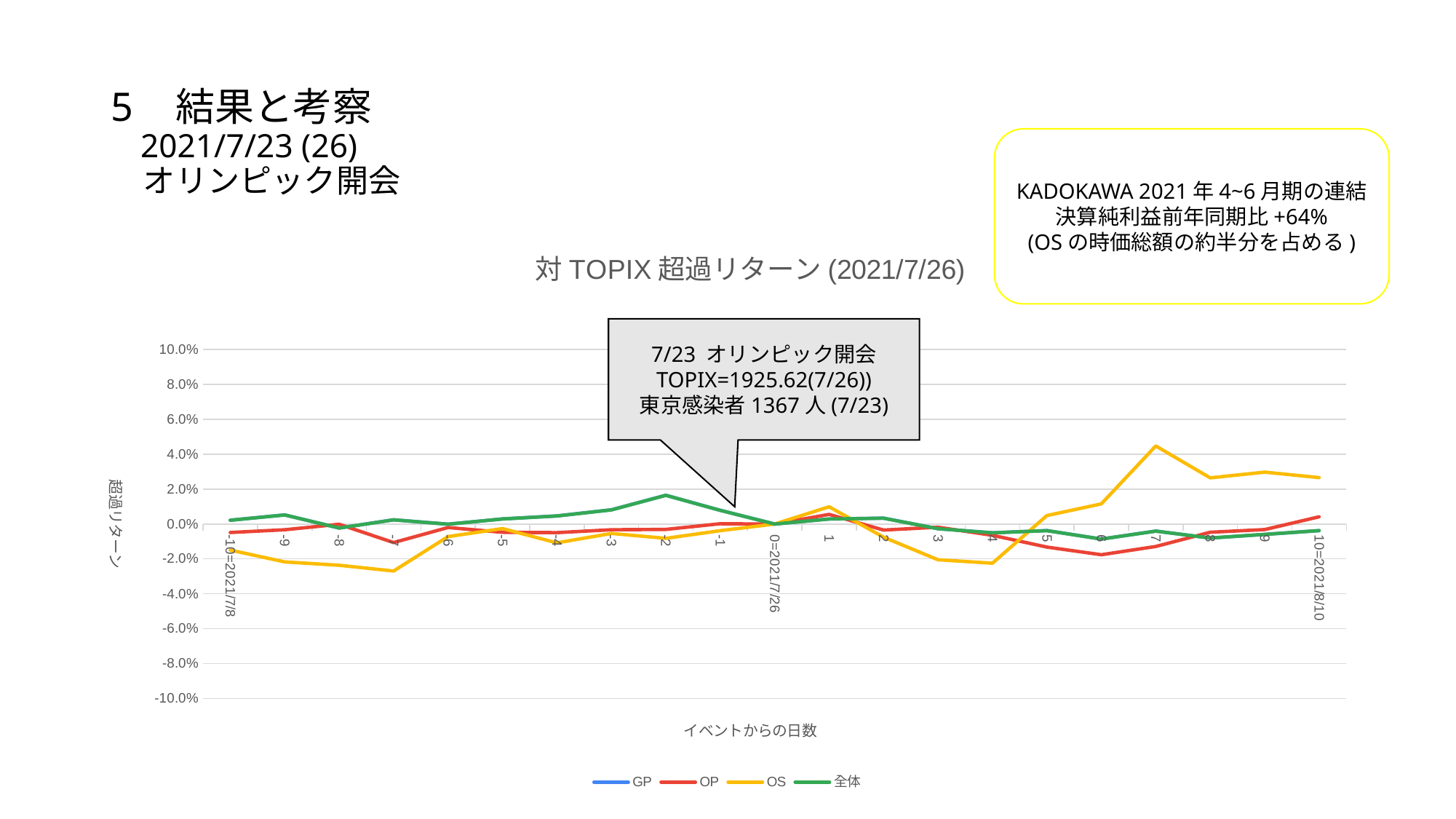
How many series does the legend list? 4 Is the value for OS at day -7 greater or less than -2.0%? less At which day does the OS series reach its highest value? 7 Does the OS series rise or fall from day 4 to day 7? rise Is the value for 全体 at day -2 greater or less than 1.0%? greater What is the title of the chart? 対 TOPIX 超過リターン (2021/7/26) How many points are on the x axis (days from the event)? 21 Which series reaches the highest value anywhere on the chart? OS At day 7, which is larger, OS or OP? OS Is the value for OS at day 7 greater or less than 4.0%? greater What kind of chart is shown on the slide? line chart